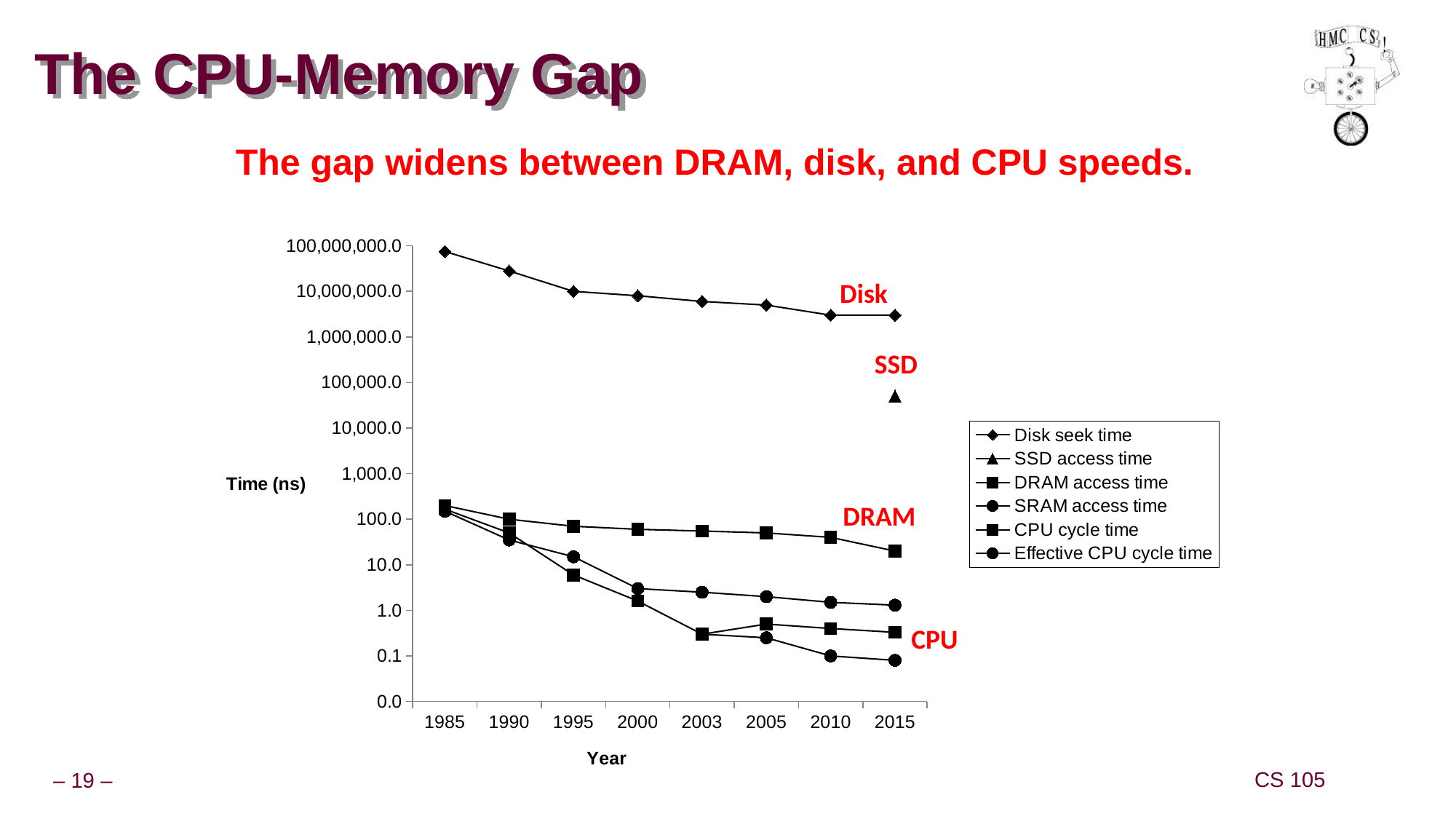
Is the SSD access time in 2015 greater or less than 100,000.0? less What is the label of the y axis? Time (ns) How many series does the legend list? 6 In 2000, which is larger: Disk seek time or DRAM access time? Disk seek time What kind of chart is shown on the slide? line chart Which series has the lowest value in 2015? Effective CPU cycle time Is the DRAM access time in 2015 greater or less than 100.0? less Which series has the highest value in 2015? Disk seek time What is the label of the x axis? Year Is the Disk seek time in 1985 greater or less than 10,000,000.0? greater Does the Disk seek time rise or fall from 1985 to 2015? fall How many years are marked along the x axis? 8